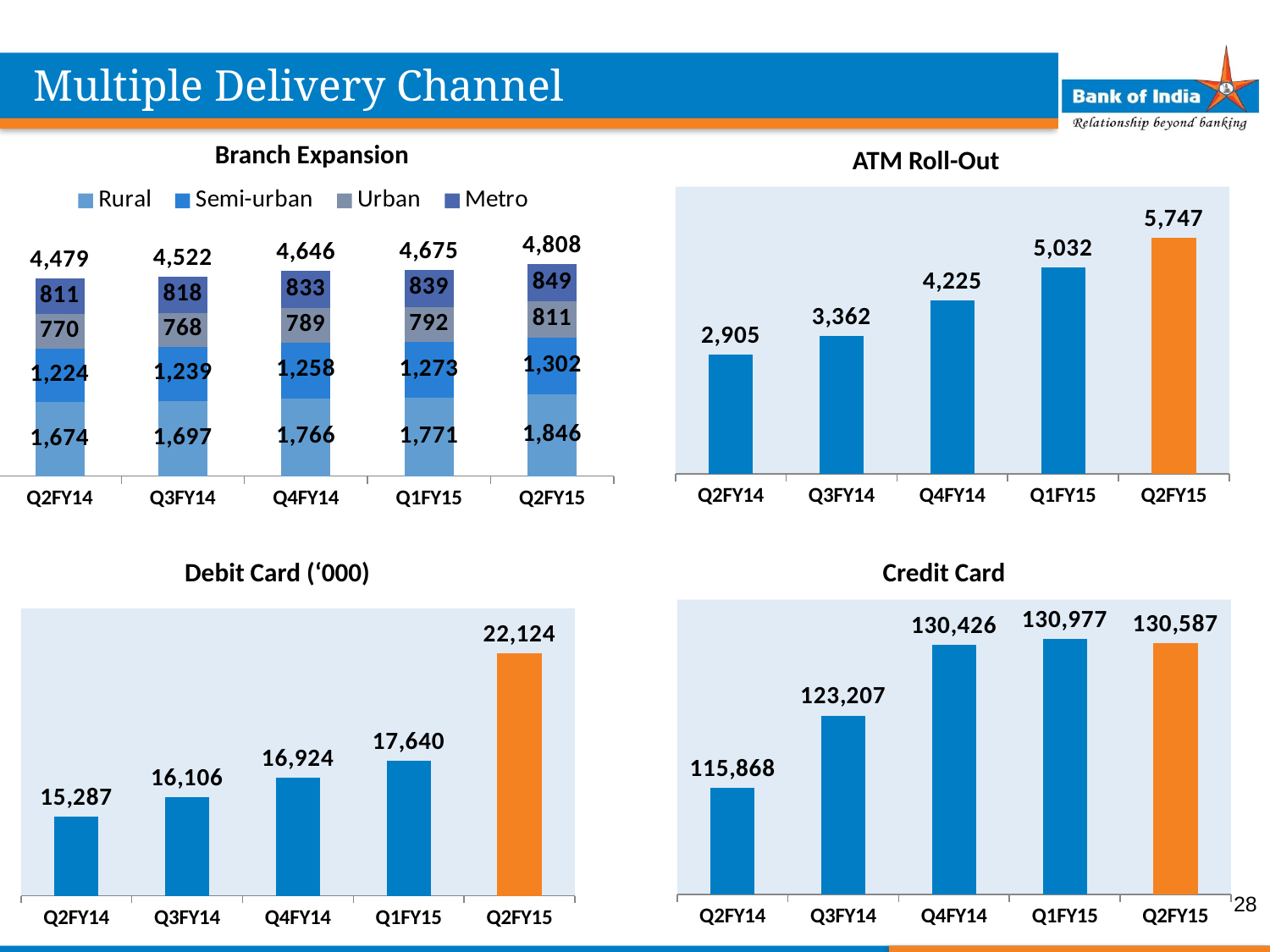
How many quarters are shown on the x axis of the Credit Card chart? 5 In the ATM Roll-Out chart, what is the difference between Q2FY15 and Q2FY14? 2,842 In the ATM Roll-Out chart, which quarter has the lowest value? Q2FY14 In the Debit Card ('000) chart, what is the value for Q4FY14? 16,924 In the Branch Expansion chart, what is the Rural value for Q2FY15? 1,846 In the Credit Card chart, which is larger, Q4FY14 or Q2FY15? Q2FY15 How many series does the legend of the Branch Expansion chart list? 4 In the Branch Expansion chart, what is the total of the stacked bar for Q4FY14? 4,646 In the Debit Card ('000) chart, do the values rise or fall from Q2FY14 to Q2FY15? rise In the ATM Roll-Out chart, what is the value for Q1FY15? 5,032 In the Credit Card chart, which quarter has the highest value? Q1FY15 In the Branch Expansion chart, what is the Metro value for Q3FY14? 818